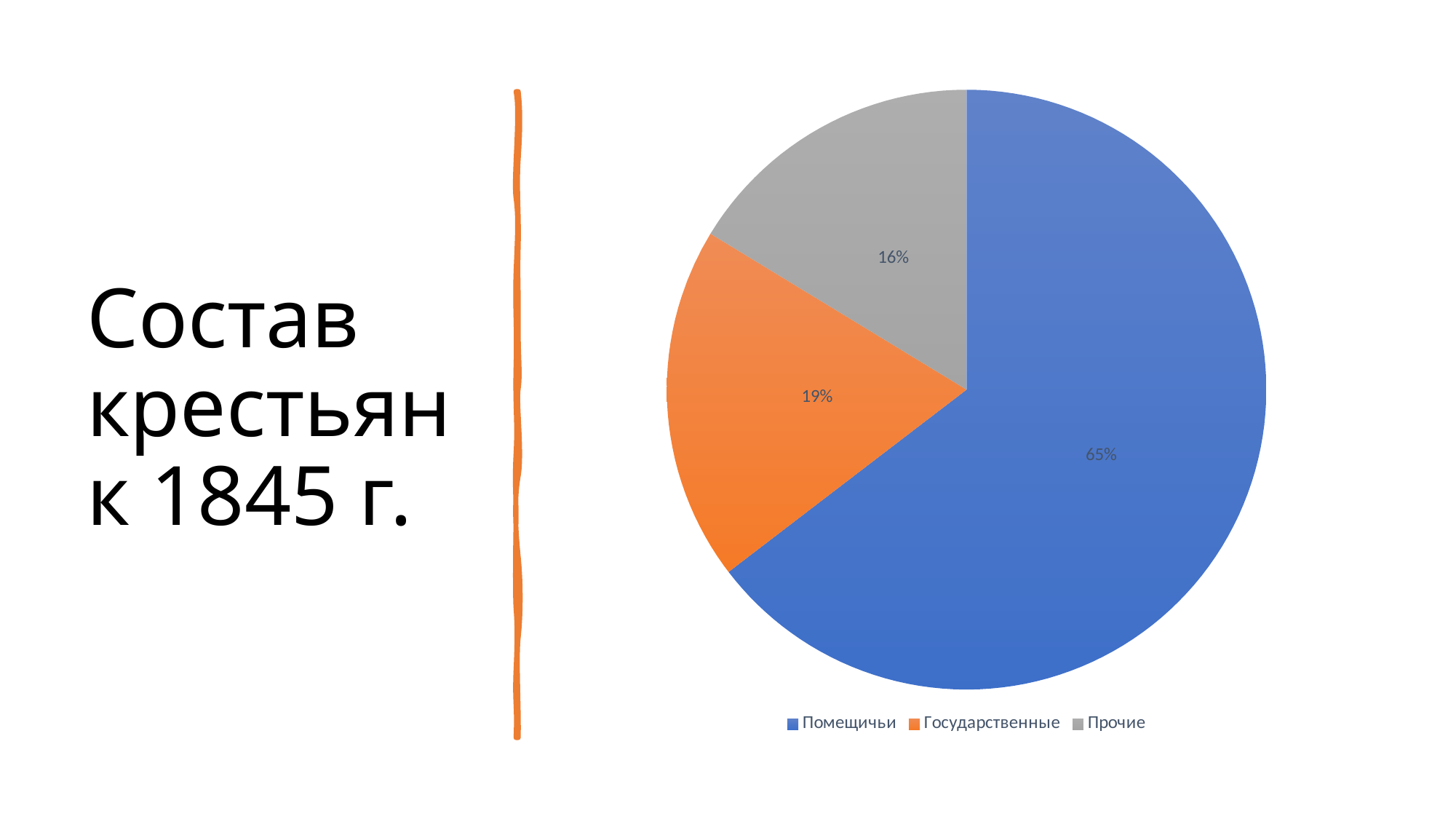
What is the title text on the slide next to the chart? Состав крестьян к 1845 г. Which is larger, the share of Помещичьи or the share of Прочие? Помещичьи What is the difference between the shares of Помещичьи and Государственные? 46% What is the value shown for Прочие? 16% What kind of chart is shown on the slide? Pie chart Which category has the smallest slice of the pie? Прочие How many categories does the pie chart show? 3 What is the value shown for Государственные? 19% Which category has the largest slice of the pie? Помещичьи What colour is the slice for Государственные? Orange What share of the pie does Помещичьи take? 65% What is the difference between the shares of Государственные and Прочие? 3%